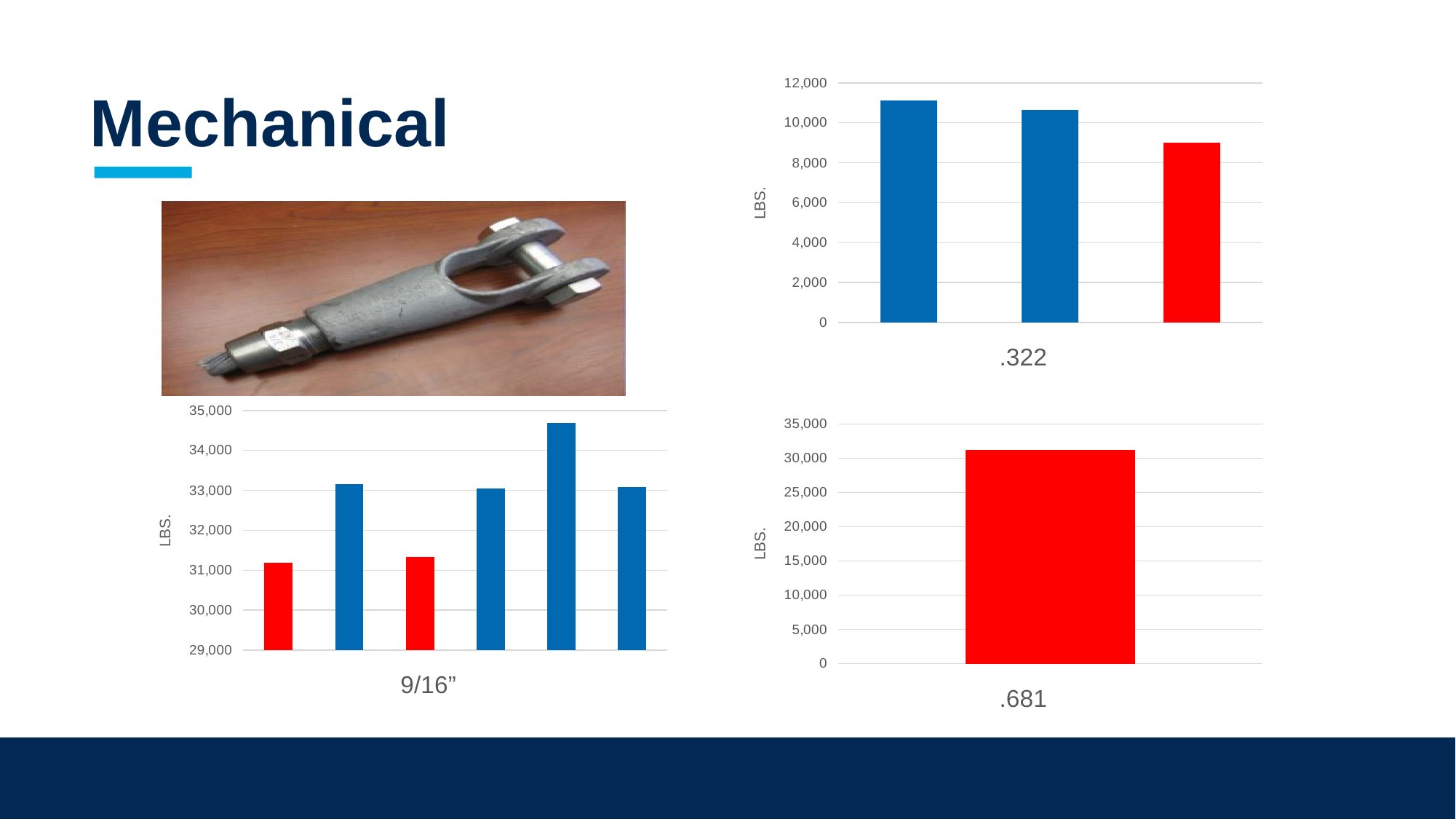
How many bars are plotted in the chart labelled ".681"? 1 In the chart labelled ".322", is the value of the first bar greater or less than 10,000? greater In the chart labelled ".681", is the value of the bar greater or less than 25,000? greater In the chart labelled "9/16"", is the value of the fifth bar greater or less than 34,000? greater How many bars are plotted in the chart labelled "9/16""? 6 How many bars are plotted in the chart labelled ".322"? 3 What is the y-axis label on the chart labelled "9/16""? LBS. What type of chart is the chart labelled ".322"? bar chart In the chart labelled "9/16"", which bar is the highest? the fifth bar In the chart labelled ".322", which bar is the lowest? the third (red) bar